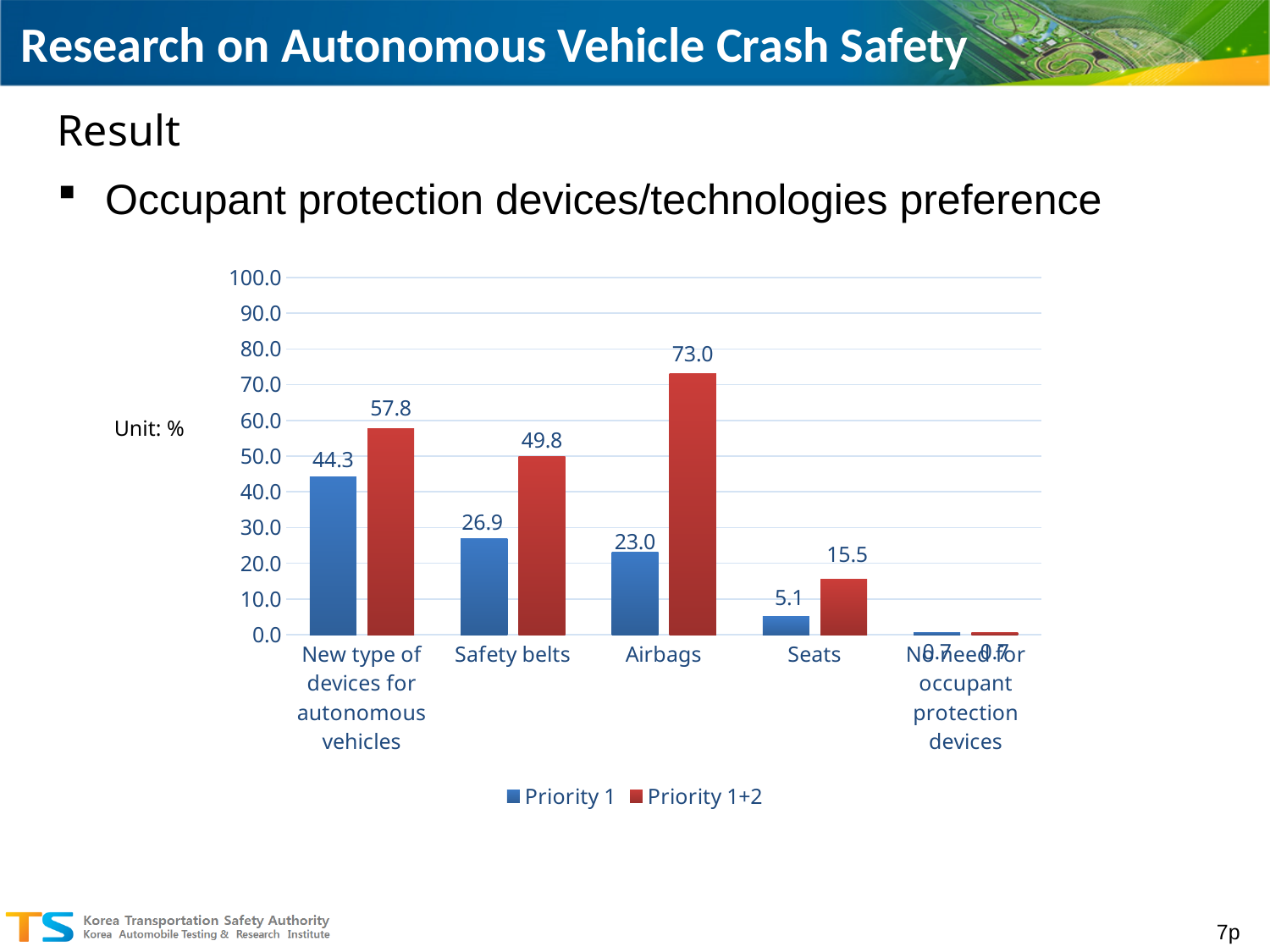
What is the Priority 1+2 value for Seats? 15.5 What is the difference between the Priority 1+2 and Priority 1 values for Airbags? 50.0 What is the Priority 1 value for New type of devices for autonomous vehicles? 44.3 What is the Priority 1+2 value for Safety belts? 49.8 What kind of chart is shown on the slide? Bar chart How many categories are shown on the x axis? 5 Which category has the highest Priority 1+2 value? Airbags What is the Priority 1 value for Airbags? 23.0 Which is larger: the Priority 1 value for Safety belts or the Priority 1 value for Airbags? Safety belts Is the Priority 1+2 value for New type of devices for autonomous vehicles greater or less than 50.0? greater How many series does the legend list? 2 Which category has the highest Priority 1 value? New type of devices for autonomous vehicles